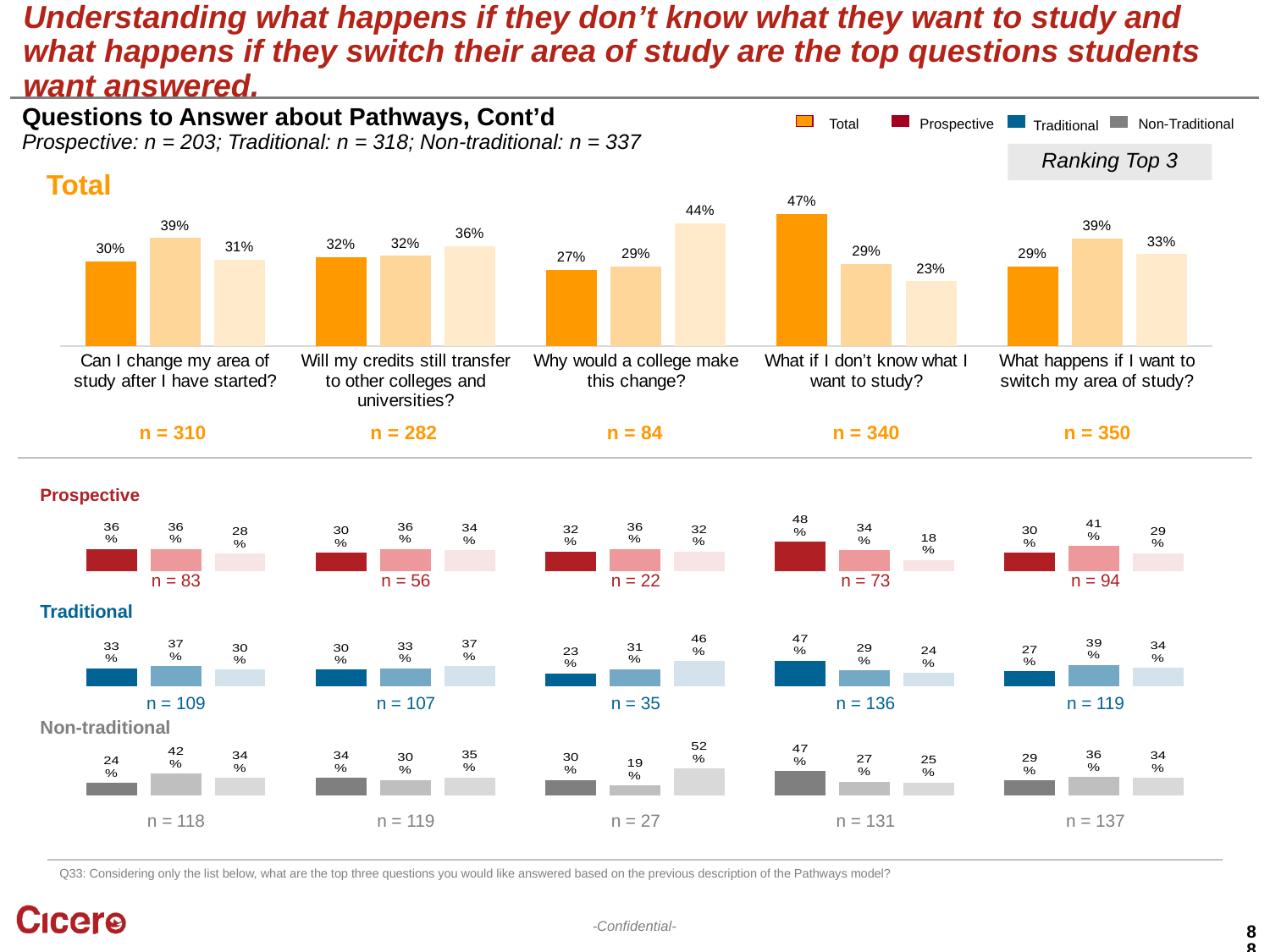
How many series does the legend at the top right list? 4 In the Total chart, what is the value of the rightmost bar for 'Why would a college make this change?' 44% In the Total chart, which is larger: the leftmost bar for 'What if I don't know what I want to study?' or the leftmost bar for 'Can I change my area of study after I have started?' What if I don't know what I want to study? In the Prospective chart, what is the value of the leftmost bar for 'What if I don't know what I want to study?' 48% In the Total chart, which question category has the highest single bar? What if I don't know what I want to study? How many question categories are shown along the x axis of the Total chart? 5 In the Traditional chart, what is the sample size (n) shown for 'Why would a college make this change?' n = 35 What kind of chart is used on this slide to show the Total results? bar chart In the Total chart, what is the value of the middle bar for 'Can I change my area of study after I have started?' 39% In the Non-traditional chart, what is the value of the rightmost bar for 'Why would a college make this change?' 52% In the Total chart, what is the difference between the middle bar (39%) and the leftmost bar (30%) for 'Can I change my area of study after I have started?' 9 percentage points In the Total chart, what is the value of the leftmost (darkest) bar for 'What if I don't know what I want to study?' 47%